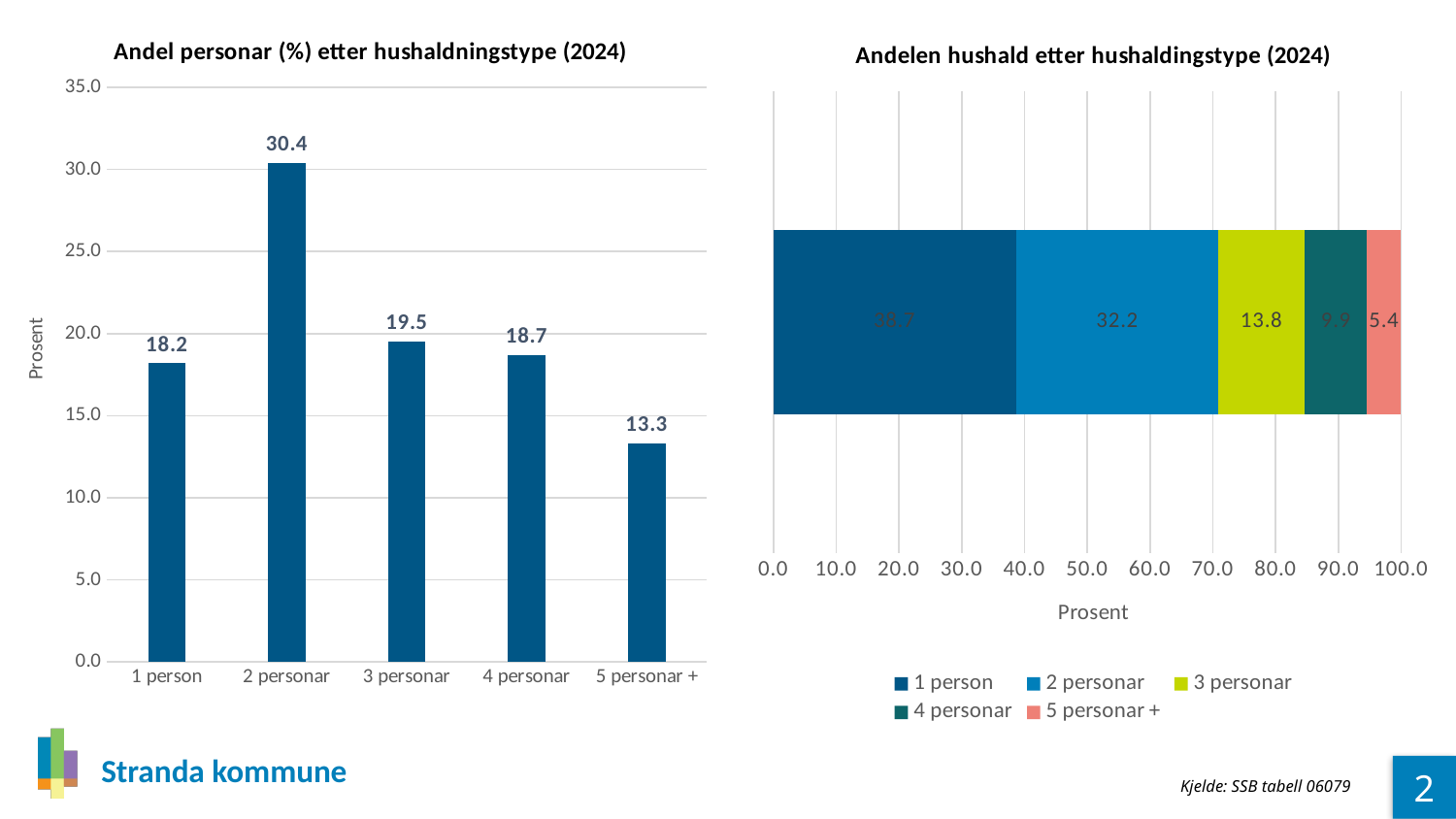
In the chart 'Andelen hushald etter hushaldingstype (2024)', what is the value for 2 personar? 32.2 In the chart 'Andelen hushald etter hushaldingstype (2024)', what is the total of the stacked bar? 100.0 What kind of chart is 'Andel personar (%) etter hushaldningstype (2024)'? Bar chart In the chart 'Andel personar (%) etter hushaldningstype (2024)', how many household types are shown on the x axis? 5 In the chart 'Andel personar (%) etter hushaldningstype (2024)', what is the value for 2 personar? 30.4 In the chart 'Andelen hushald etter hushaldingstype (2024)', what is the value for 3 personar? 13.8 In the chart 'Andel personar (%) etter hushaldningstype (2024)', what is the value for 5 personar +? 13.3 In the chart 'Andel personar (%) etter hushaldningstype (2024)', which household type has the highest value? 2 personar In the chart 'Andel personar (%) etter hushaldningstype (2024)', which household type has the lowest value? 5 personar + In the chart 'Andel personar (%) etter hushaldningstype (2024)', which is larger, the value for 3 personar or 4 personar? 3 personar In the chart 'Andel personar (%) etter hushaldningstype (2024)', what is the difference between the values for 2 personar and 1 person? 12.2 In the chart 'Andelen hushald etter hushaldingstype (2024)', how many series does the legend list? 5